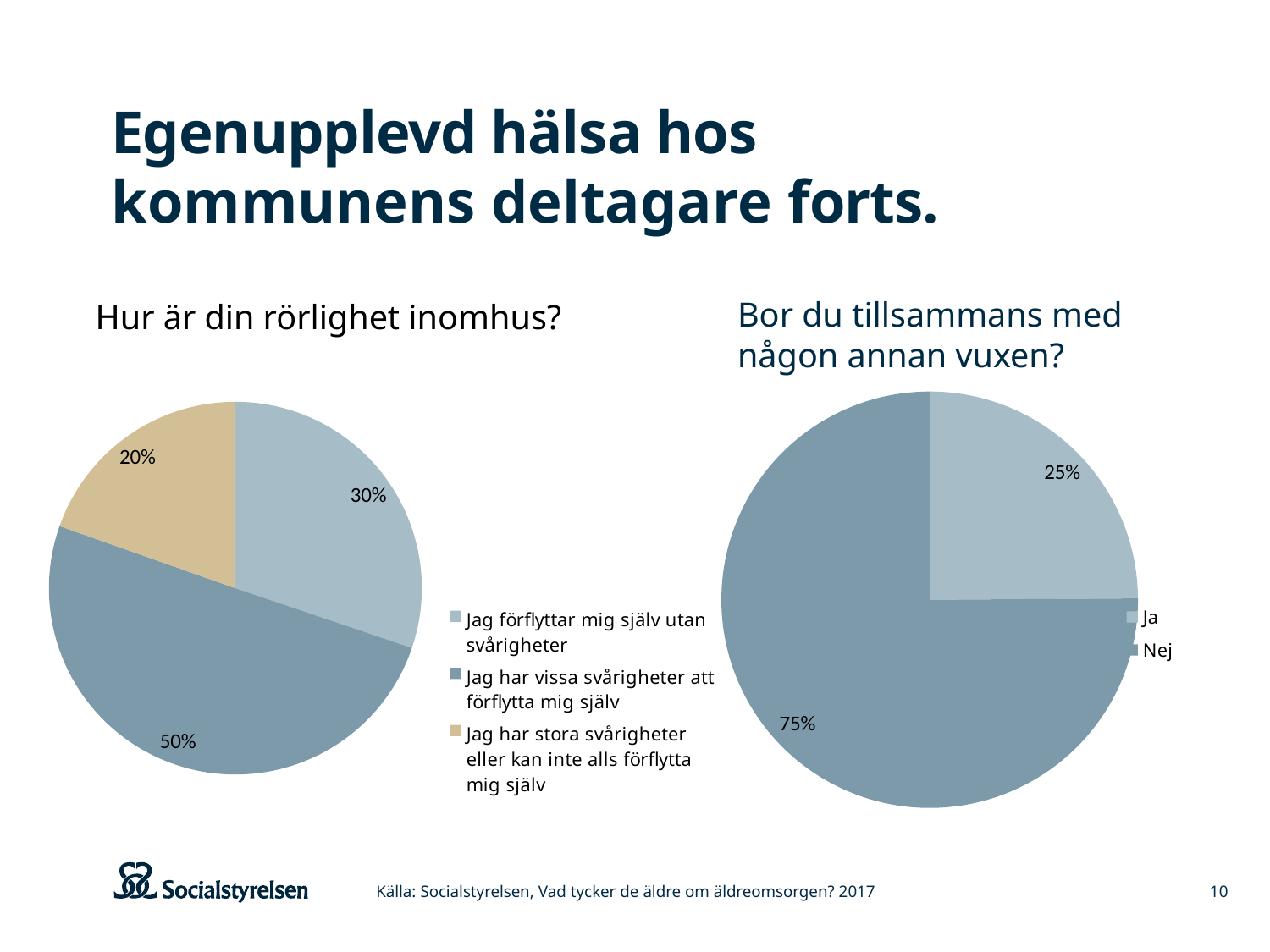
In the chart 'Bor du tillsammans med någon annan vuxen?', what share is labelled for 'Ja'? 25% In the chart 'Hur är din rörlighet inomhus?', what is the difference in percentage points between the 50% slice and the 20% slice? 30 percentage points In the chart 'Hur är din rörlighet inomhus?', how many slices does the pie have? 3 In the chart 'Hur är din rörlighet inomhus?', which category has the smallest slice? Jag har stora svårigheter eller kan inte alls förflytta mig själv In the chart 'Bor du tillsammans med någon annan vuxen?', which answer has the larger slice, 'Ja' or 'Nej'? Nej How many entries does the legend of the chart 'Bor du tillsammans med någon annan vuxen?' list? 2 In the chart 'Hur är din rörlighet inomhus?', what share is labelled for 'Jag förflyttar mig själv utan svårigheter'? 30% In the chart 'Hur är din rörlighet inomhus?', what share is labelled for 'Jag har vissa svårigheter att förflytta mig själv'? 50% In the chart 'Hur är din rörlighet inomhus?', which category has the largest slice? Jag har vissa svårigheter att förflytta mig själv In the chart 'Hur är din rörlighet inomhus?', what share is labelled for 'Jag har stora svårigheter eller kan inte alls förflytta mig själv'? 20% What type of chart is used for 'Bor du tillsammans med någon annan vuxen?'? Pie chart In the chart 'Bor du tillsammans med någon annan vuxen?', what share is labelled for 'Nej'? 75%